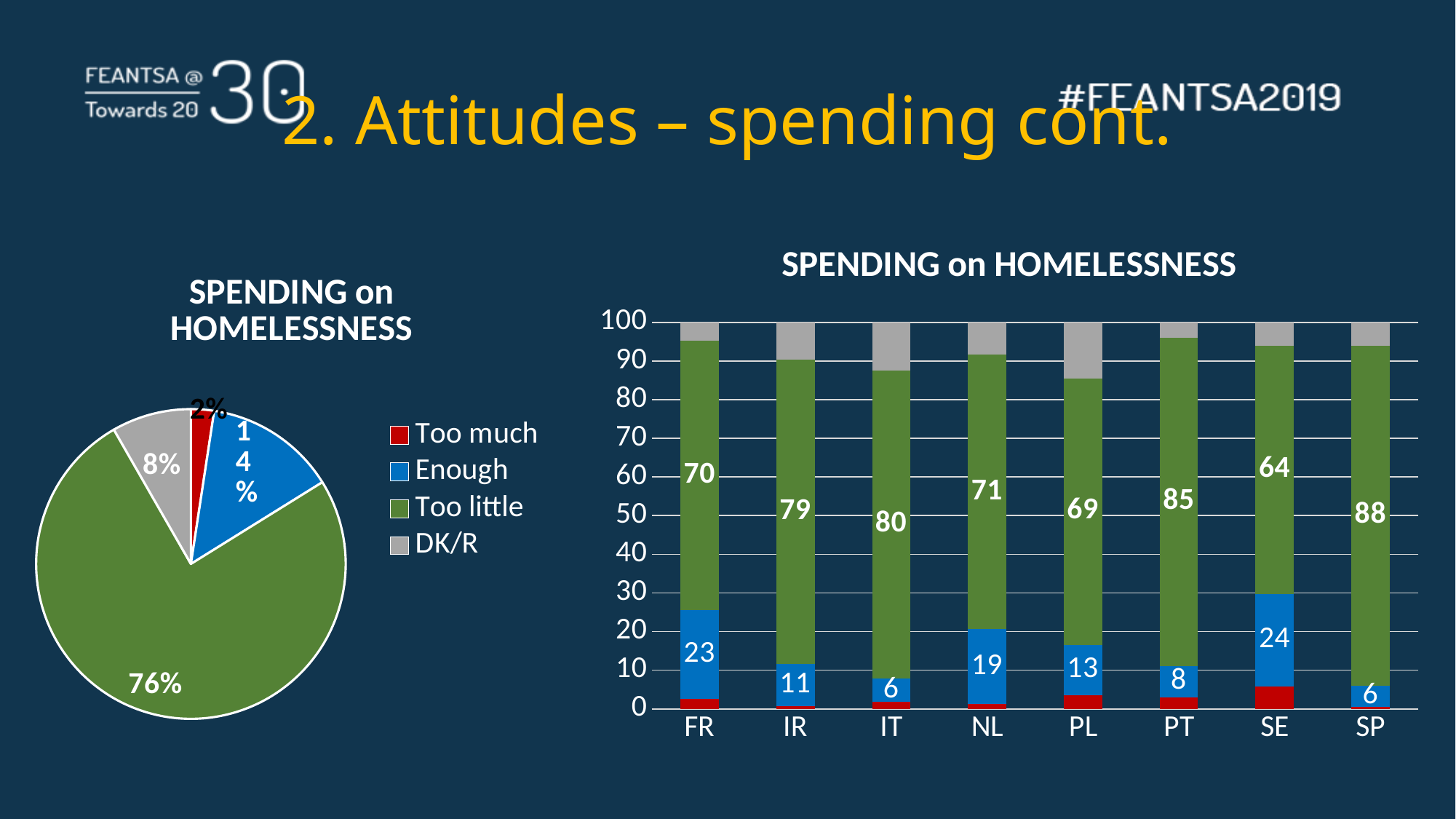
In the pie chart on the left, what share of the pie is 'Too little'? 76% In the pie chart on the left, which slice is the smallest? Too much In the stacked bar chart on the right, how many countries are shown on the x axis? 8 In the pie chart on the left, what share of the pie is 'DK/R'? 8% In the stacked bar chart on the right, what is the 'Enough' value for SE? 24 In the stacked bar chart on the right, what is the 'Too little' value for SP? 88 In the stacked bar chart on the right, what is the difference between the 'Too little' values for PT and FR? 15 In the stacked bar chart on the right, which is larger, the 'Enough' value for NL or for PL? NL In the stacked bar chart on the right, which country has the highest 'Too little' value? SP In the pie chart on the left, how many entries does the legend list? 4 What kind of chart is the chart on the right of the slide? Stacked bar chart In the stacked bar chart on the right, which country has the lowest 'Too little' value? SE